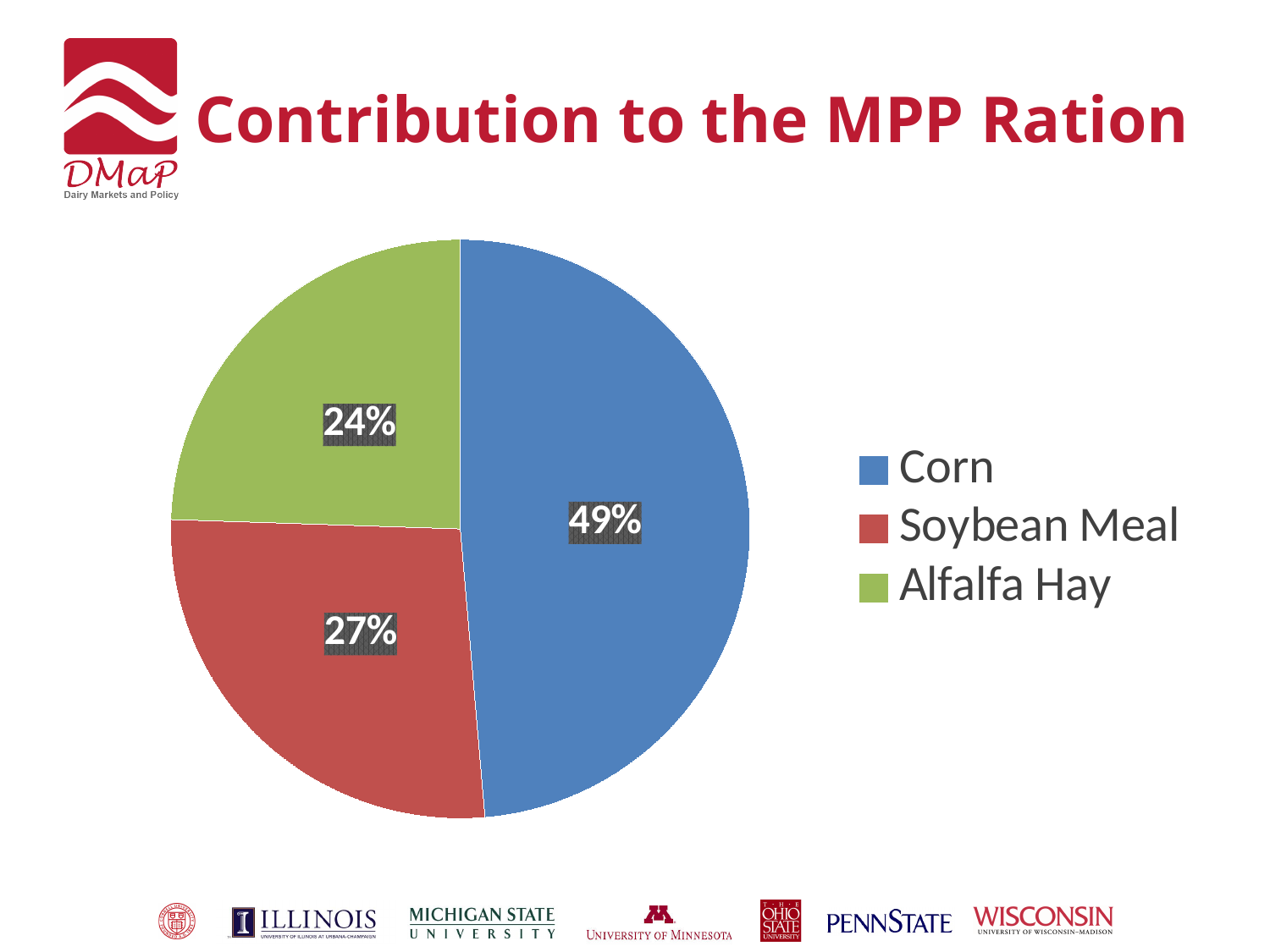
What is the title of the chart? Contribution to the MPP Ration How many ingredients are shown in the pie chart? 3 What kind of chart is shown on the slide? Pie chart What share of the MPP ration does Soybean Meal contribute? 27% Which contributes a larger share of the MPP ration, Soybean Meal or Alfalfa Hay? Soybean Meal What share of the MPP ration does Alfalfa Hay contribute? 24% Which ingredient contributes the smallest share of the MPP ration? Alfalfa Hay Which colour represents Alfalfa Hay in the pie chart? Green How many percentage points larger is Soybean Meal's share than Alfalfa Hay's share? 3 How many percentage points larger is Corn's share than Soybean Meal's share? 22 Which ingredient contributes the largest share of the MPP ration? Corn What share of the MPP ration does Corn contribute? 49%